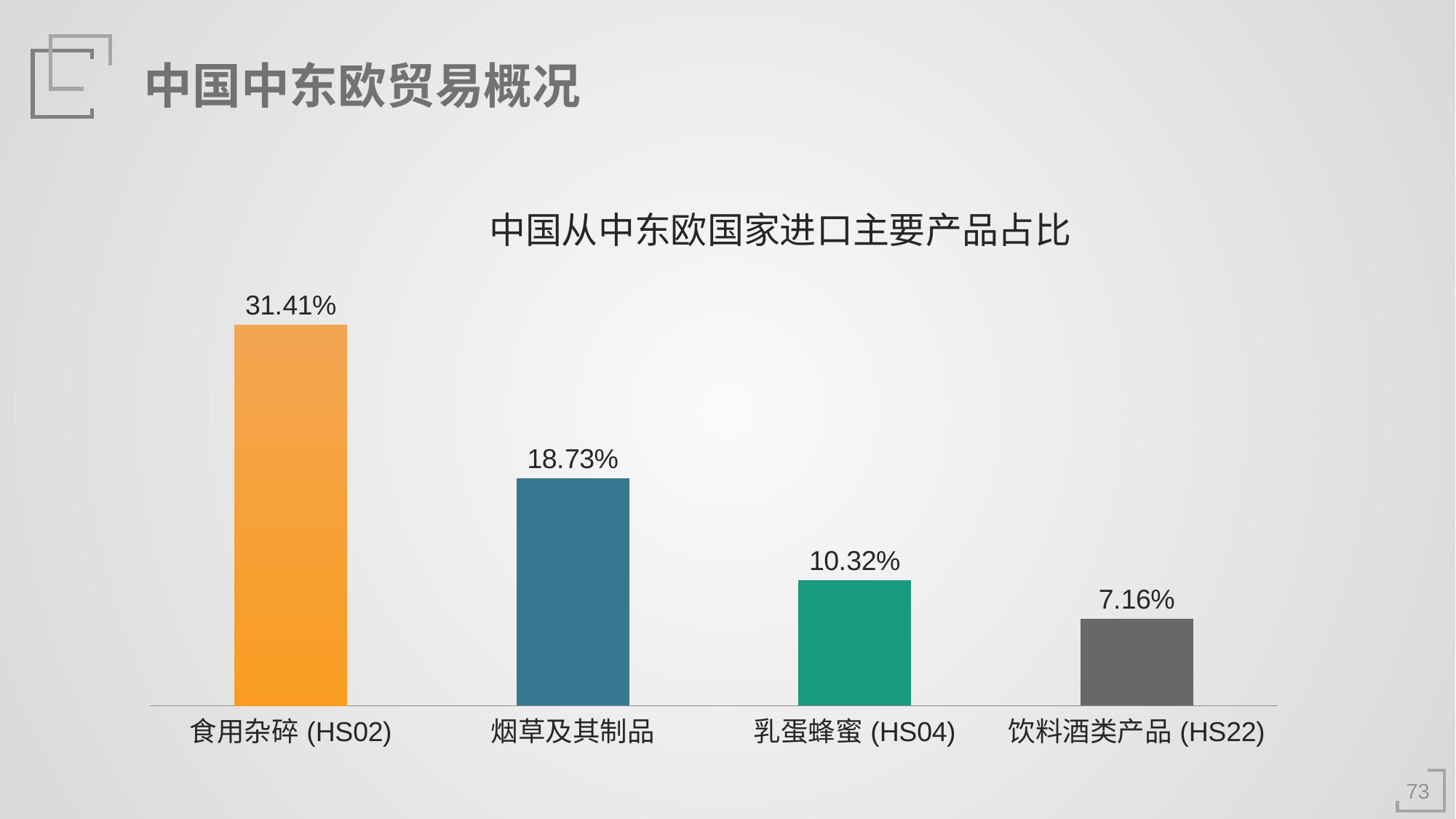
Which category has the highest value? 食用杂碎 (HS02) What is the value for 乳蛋蜂蜜 (HS04)? 10.32% Which category has the lowest value? 饮料酒类产品 (HS22) What is the value for 食用杂碎 (HS02)? 31.41% What is the title of the chart? 中国从中东欧国家进口主要产品占比 What kind of chart is shown on the slide? bar chart How many categories are shown in the chart? 4 Which is larger, the value for 烟草及其制品 or the value for 乳蛋蜂蜜 (HS04)? 烟草及其制品 What is the value for 饮料酒类产品 (HS22)? 7.16% What is the value for 烟草及其制品? 18.73% What is the difference between the values for 乳蛋蜂蜜 (HS04) and 饮料酒类产品 (HS22)? 3.16% What is the difference between the values for 食用杂碎 (HS02) and 烟草及其制品? 12.68%